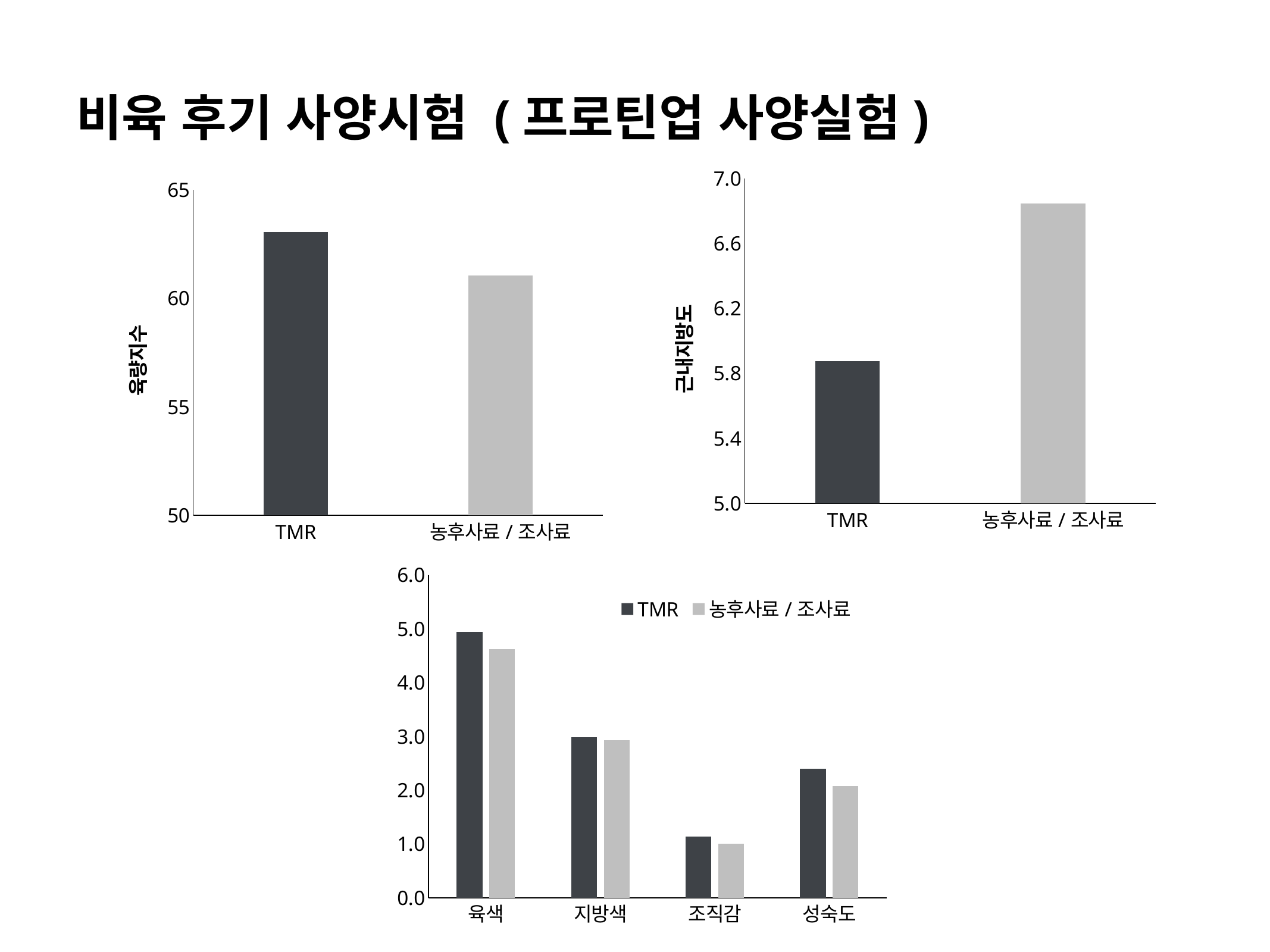
In the top-left chart (육량지수), is the value for 농후사료 / 조사료 greater or less than 65? less In the top-right chart (근내지방도), is the value for 농후사료 / 조사료 greater or less than 6.6? greater In the bottom chart, which category has the highest TMR value? 육색 In the top-left chart (육량지수), is the value for TMR greater or less than 60? greater In the bottom chart, which category has the lowest 농후사료 / 조사료 value? 조직감 In the bottom chart, how many categories are shown on the x axis? 4 In the bottom chart, how many series does the legend list? 2 In the top-left chart (육량지수), which category has the higher value, TMR or 농후사료 / 조사료? TMR In the top-right chart (근내지방도), which category has the higher value, TMR or 농후사료 / 조사료? 농후사료 / 조사료 What type of chart is the bottom chart? bar chart